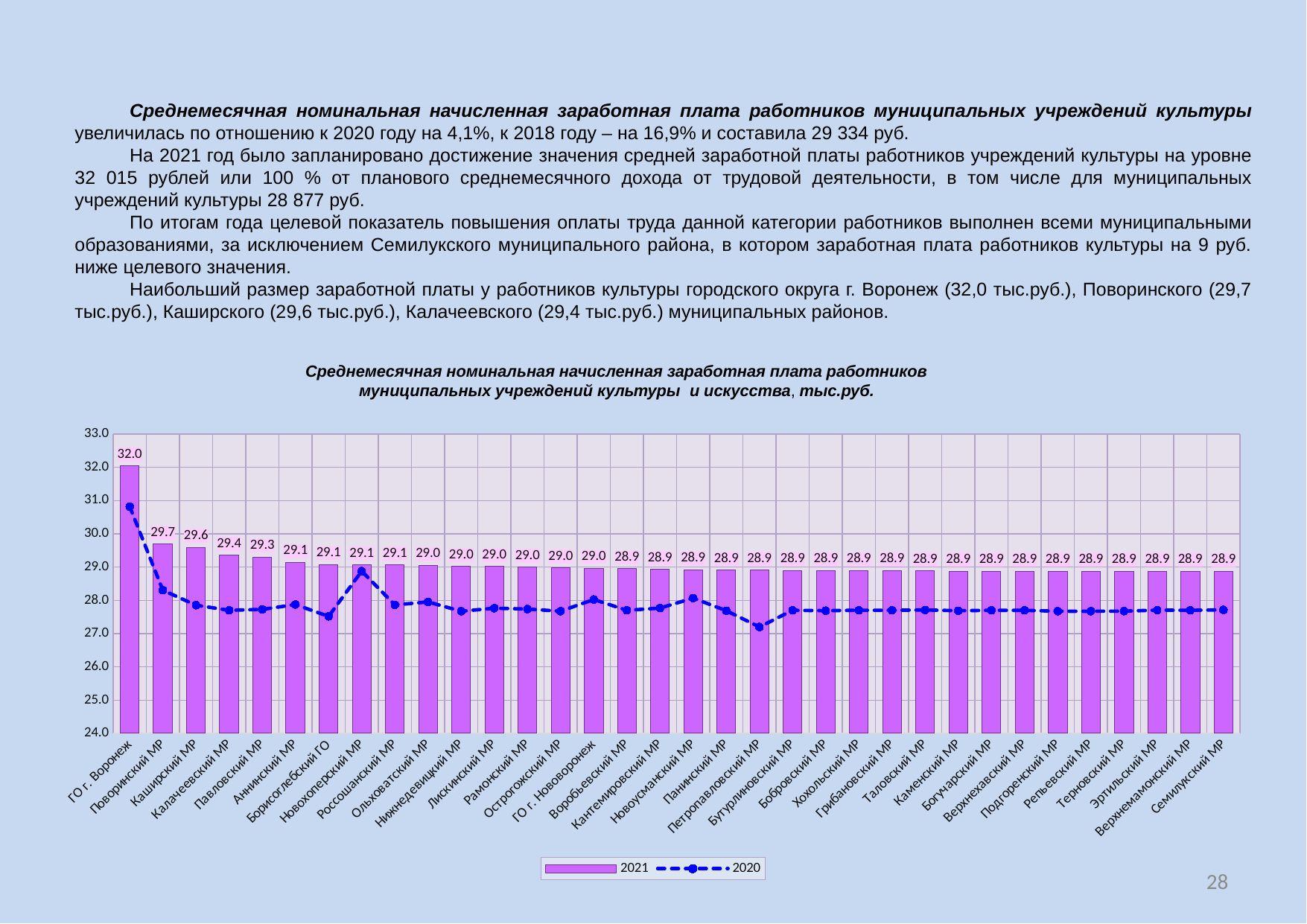
What is the 2021 value for Калачеевский МР? 29.4 What is the 2021 value for ГО г. Воронеж? 32.0 What type of chart is shown on the slide? bar chart (with a line series) What is the 2021 value for Семилукский МР? 28.9 Which category has the highest 2021 value? ГО г. Воронеж Is the 2020 value for ГО г. Воронеж greater or less than 30.0? greater Which has a larger 2021 value, Каширский МР or Павловский МР? Каширский МР How many categories are shown on the x axis? 34 What is the 2021 value for Поворинский МР? 29.7 How many series does the legend list? 2 Is the 2020 value for Петропавловский МР greater or less than 28.0? less What is the difference between the 2021 values for ГО г. Воронеж and Поворинский МР? 2.3